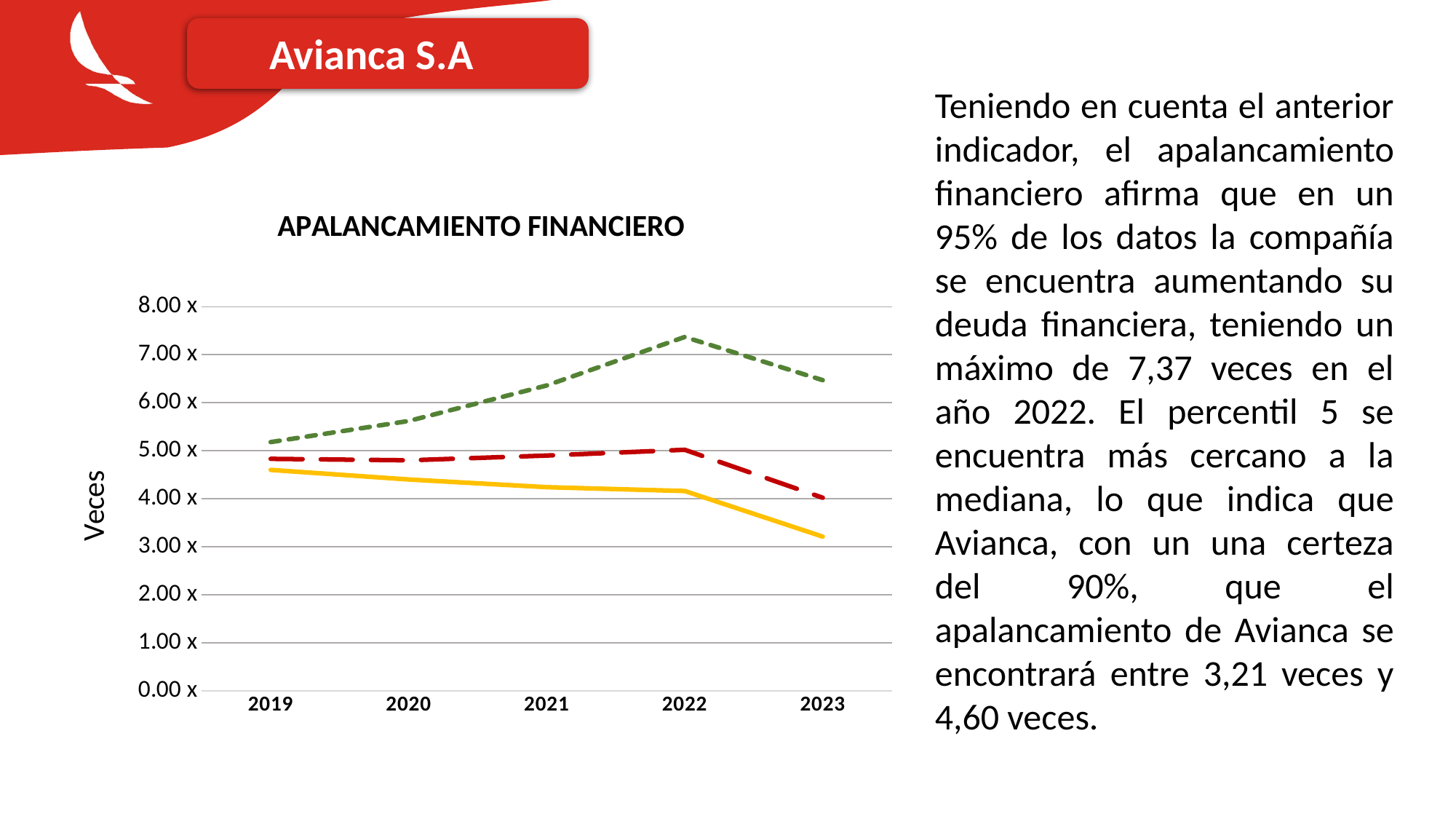
Does the yellow solid line rise or fall from 2019 to 2023? fall Does the green dotted line rise or fall from 2019 to 2022? rise What is the title of the chart? APALANCAMIENTO FINANCIERO Is the value of the green dotted line in 2022 greater or less than 7.00 x? greater What is the label on the vertical axis of the chart? Veces In which year does the green dotted line reach its highest value? 2022 Which line has the higher value in 2023, the green dotted line or the red dashed line? the green dotted line Is the value of the red dashed line in 2019 greater or less than 4.00 x? greater Is the value of the yellow solid line in 2023 greater or less than 4.00 x? less In which year does the yellow solid line reach its lowest value? 2023 What kind of chart is shown on the slide? line chart How many years are shown along the x axis of the chart? 5